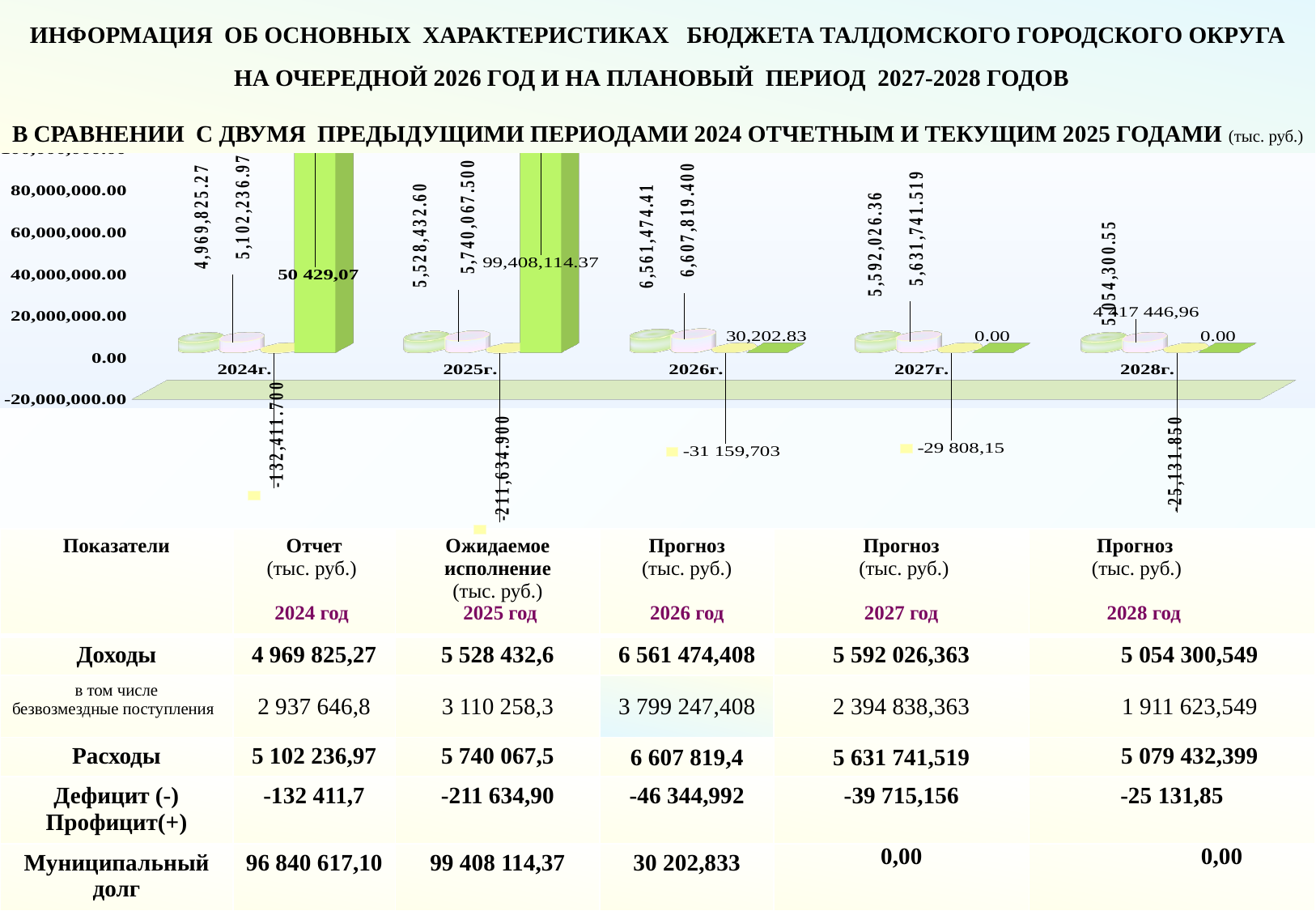
Is the tall green bar for 2025г. greater or less than 80,000,000.00? greater What value is labelled on the tall green bar for 2025г. in the chart? 99,408,114.37 How many year categories are shown along the x axis of the chart? 5 What negative value is labelled below the axis for 2028г. in the chart? -25,131.850 What value is labelled on the green bar for 2027г. in the chart? 0.00 What value is labelled on the green bar for 2026г. in the chart? 30,202.83 What negative value is labelled below the axis for 2025г. in the chart? -211,634.900 Which year has the highest first (leftmost) data label in the chart? 2026г. What is the second data label above the 2027г. group in the chart? 5,631,741.519 What kind of chart is shown on the slide? bar chart Which is larger in the chart: the green bar label for 2025г. or the green bar label for 2026г.? 2025г. What is the first (leftmost) data label above the 2024г. group in the chart? 4,969,825.27